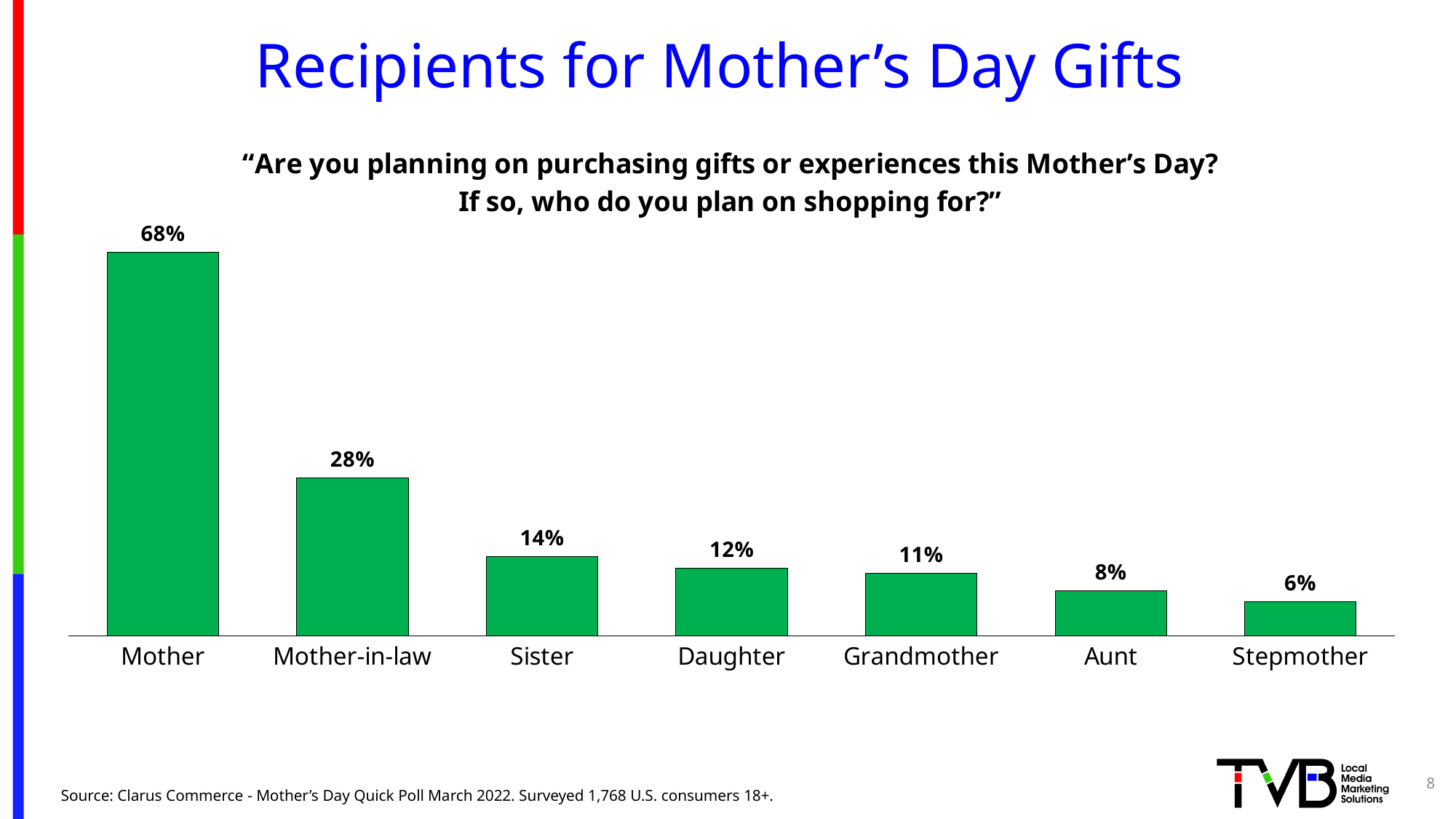
What colour are the bars in the chart? Green What kind of chart is shown on the slide? Bar chart Which recipient category has the highest value? Mother Which recipient category has the lowest value? Stepmother What is the value shown for Stepmother? 6% How many recipient categories are shown in the chart? 7 Which is larger, the value for Daughter or the value for Grandmother? Daughter What percentage of respondents plan to shop for their Mother? 68% What is the difference between the values for Sister and Aunt? 6% Do the values rise or fall moving from left to right across the categories? Fall What is the difference between the values for Mother and Mother-in-law? 40% What is the value shown for Grandmother? 11%